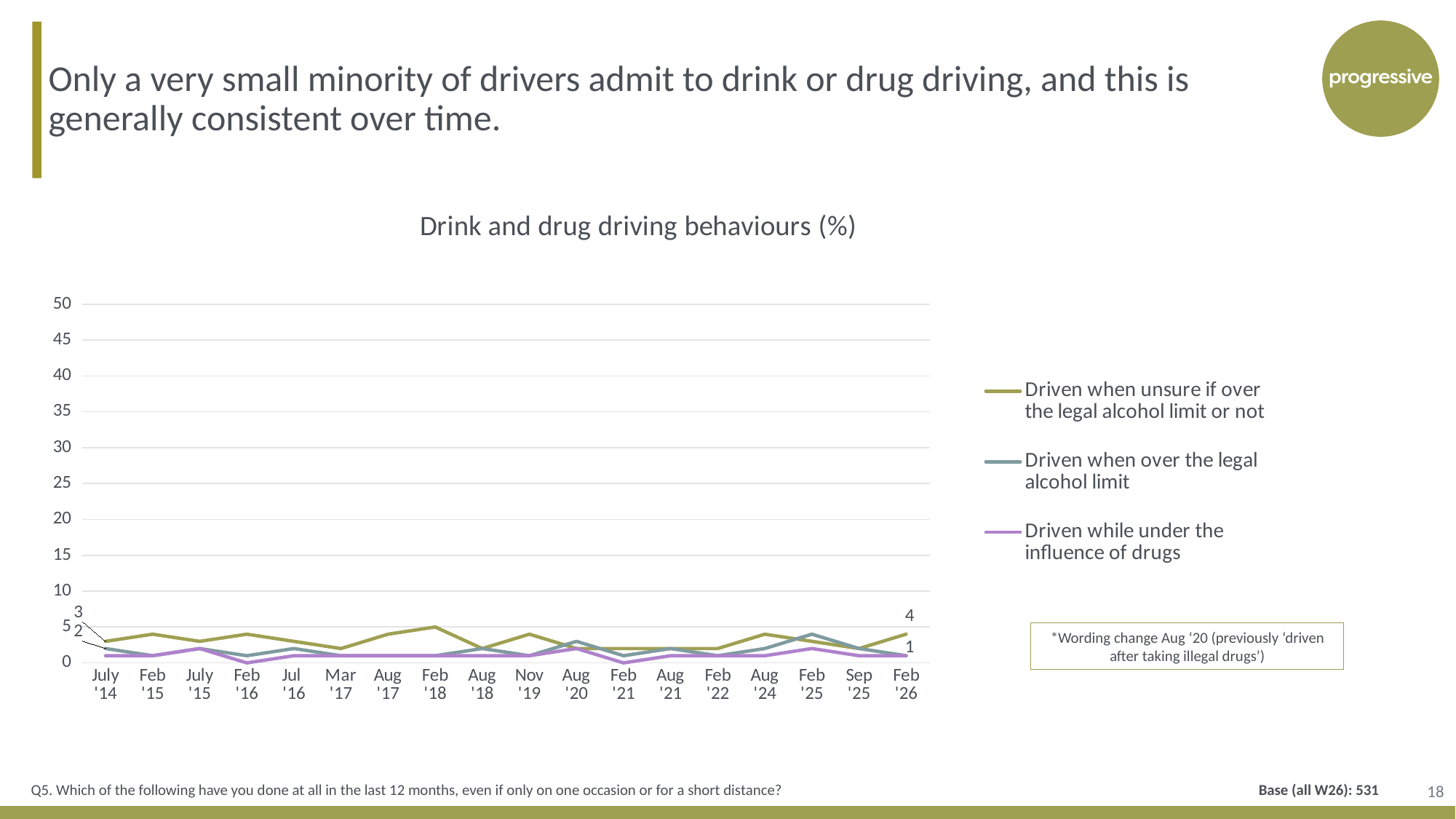
What is the value for 'Driven when unsure if over the legal alcohol limit or not' at Feb '26? 4 At Feb '26, which is larger: 'Driven when unsure if over the legal alcohol limit or not' or 'Driven while under the influence of drugs'? Driven when unsure if over the legal alcohol limit or not How many series does the legend list? 3 Which series has the highest value at Feb '18? Driven when unsure if over the legal alcohol limit or not Is the value for 'Driven when unsure if over the legal alcohol limit or not' at Feb '18 greater or less than 10? less Is the value for 'Driven while under the influence of drugs' at Feb '21 greater or less than 5? less Which series has the highest value at Feb '26? Driven when unsure if over the legal alcohol limit or not What type of chart is shown on the slide? line chart Is the value for 'Driven when over the legal alcohol limit' at Feb '25 greater or less than 10? less What is the title of the chart? Drink and drug driving behaviours (%) How many time points are shown on the x axis? 18 What is the maximum value shown on the y axis? 50